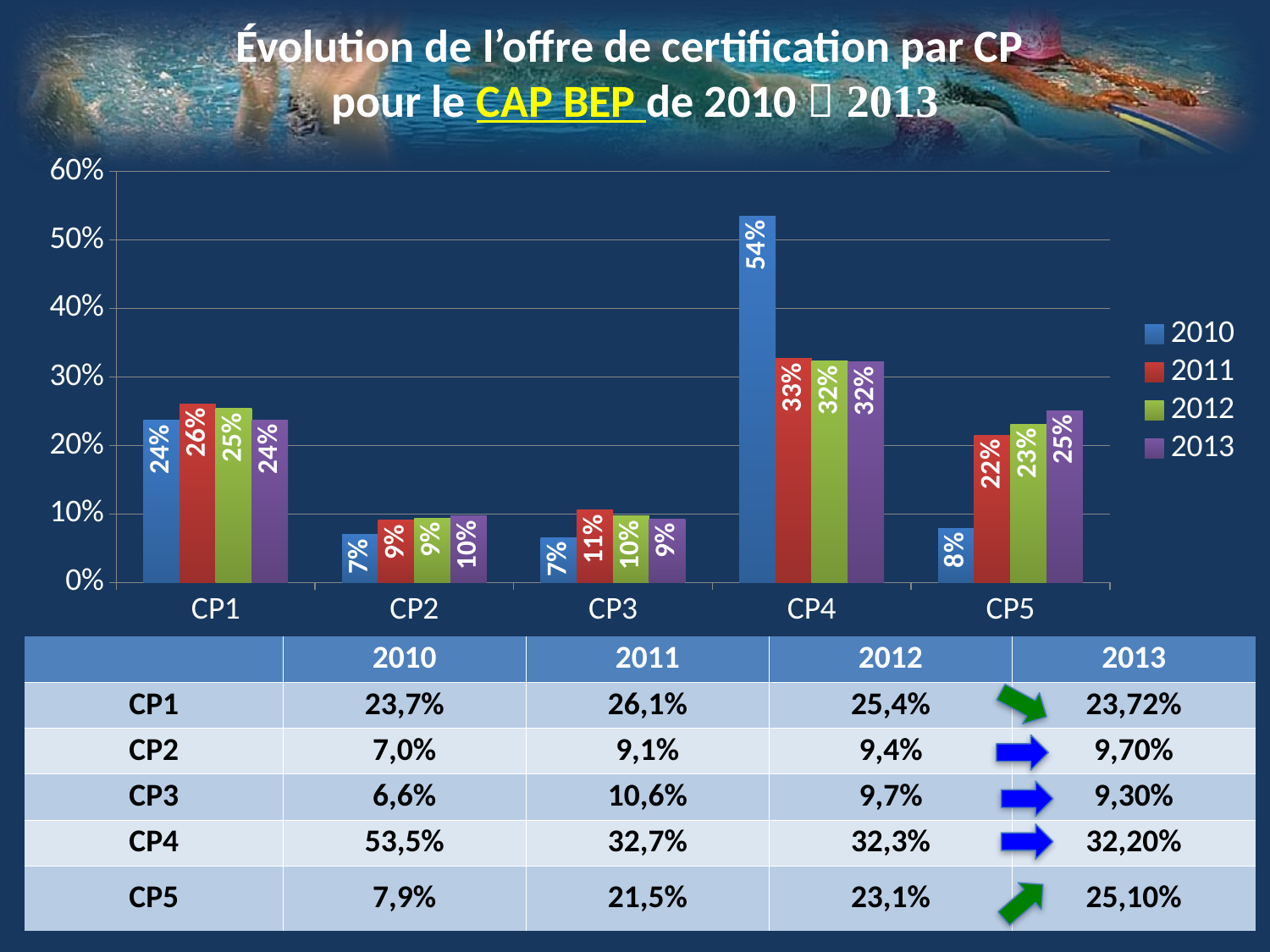
What is the value for CP4 in 2010 according to the chart's data label? 54% Using the chart's data labels, what is the difference between the 2010 and 2011 values for CP4? 21% How many categories are shown on the x axis of the chart? 5 Which is larger: the 2011 value for CP1 or the 2011 value for CP5? 2011 value for CP1 Which category has the highest value for the 2010 series? CP4 How many series does the chart's legend list? 4 Is the value for CP4 in 2010 greater or less than 50%? greater Which category has the lowest value for the 2013 series? CP3 What kind of chart is shown on the slide? bar chart Using the chart's data labels, what is the difference between the 2010 and 2013 values for CP5? 17% What is the value for CP5 in 2013 according to the chart's data label? 25% What is the value for CP3 in 2011 according to the chart's data label? 11%